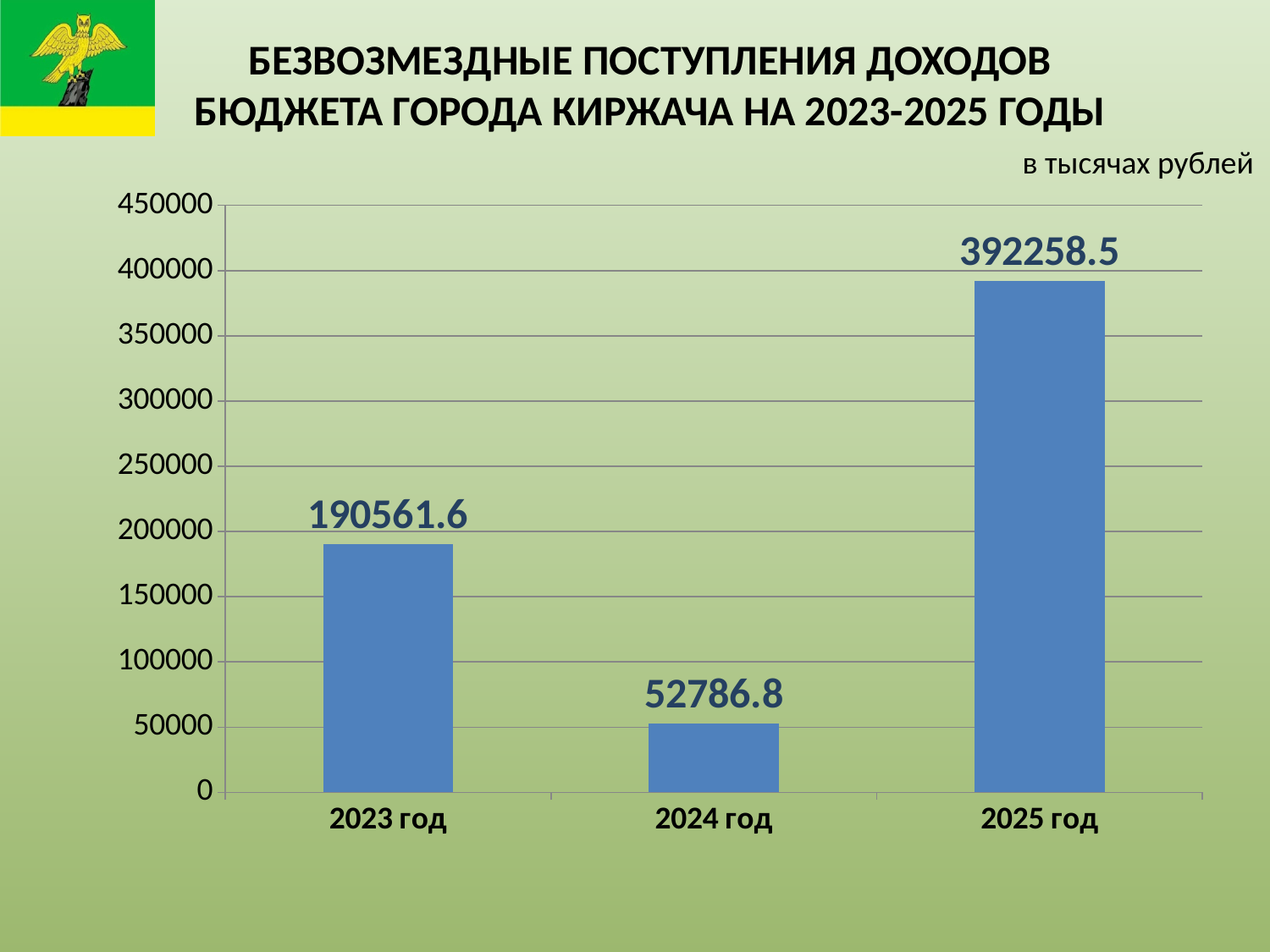
What is the value for 2024 год? 52786.8 What kind of chart is shown on the slide? bar chart What is the value for 2025 год? 392258.5 What is the value for 2023 год? 190561.6 In what units are the values on the chart given? в тысячах рублей Which year has the lowest value? 2024 год What is the difference between the values for 2023 год and 2024 год? 137774.8 What is the difference between the values for 2025 год and 2023 год? 201696.9 How many years are shown on the chart? 3 Which is larger, the value for 2023 год or the value for 2024 год? 2023 год Which year has the highest value? 2025 год Is the value for 2025 год greater or less than 350000? greater